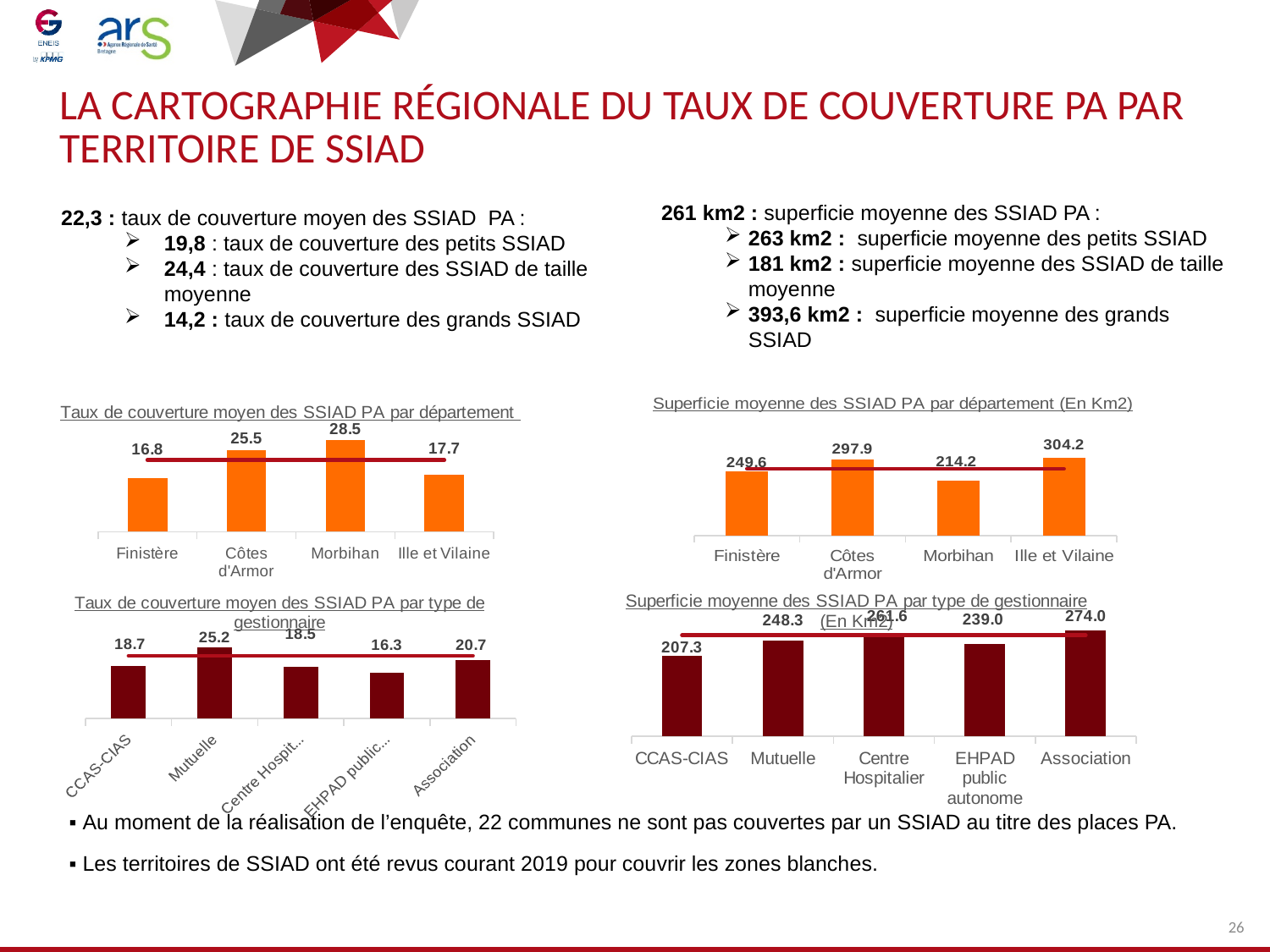
In the chart 'Taux de couverture moyen des SSIAD PA par type de gestionnaire', what is the value for Mutuelle? 25.2 In the chart 'Superficie moyenne des SSIAD PA par type de gestionnaire (En Km2)', what is the value for EHPAD public autonome? 239.0 What type of chart is 'Superficie moyenne des SSIAD PA par type de gestionnaire (En Km2)'? Bar chart In the chart 'Taux de couverture moyen des SSIAD PA par département', what is the value for Morbihan? 28.5 In the chart 'Superficie moyenne des SSIAD PA par département (En Km2)', what is the value for Finistère? 249.6 In the chart 'Taux de couverture moyen des SSIAD PA par département', what is the difference between Côtes d'Armor and Ille et Vilaine? 7.8 In the chart 'Superficie moyenne des SSIAD PA par type de gestionnaire (En Km2)', what is the difference between Association and CCAS-CIAS? 66.7 In the chart 'Superficie moyenne des SSIAD PA par département (En Km2)', which is larger, Côtes d'Armor or Morbihan? Côtes d'Armor In the chart 'Taux de couverture moyen des SSIAD PA par type de gestionnaire', what is the value for Association? 20.7 In the chart 'Taux de couverture moyen des SSIAD PA par type de gestionnaire', how many categories are shown? 5 In the chart 'Taux de couverture moyen des SSIAD PA par département', which department has the lowest value? Finistère In the chart 'Superficie moyenne des SSIAD PA par département (En Km2)', which department has the highest value? Ille et Vilaine